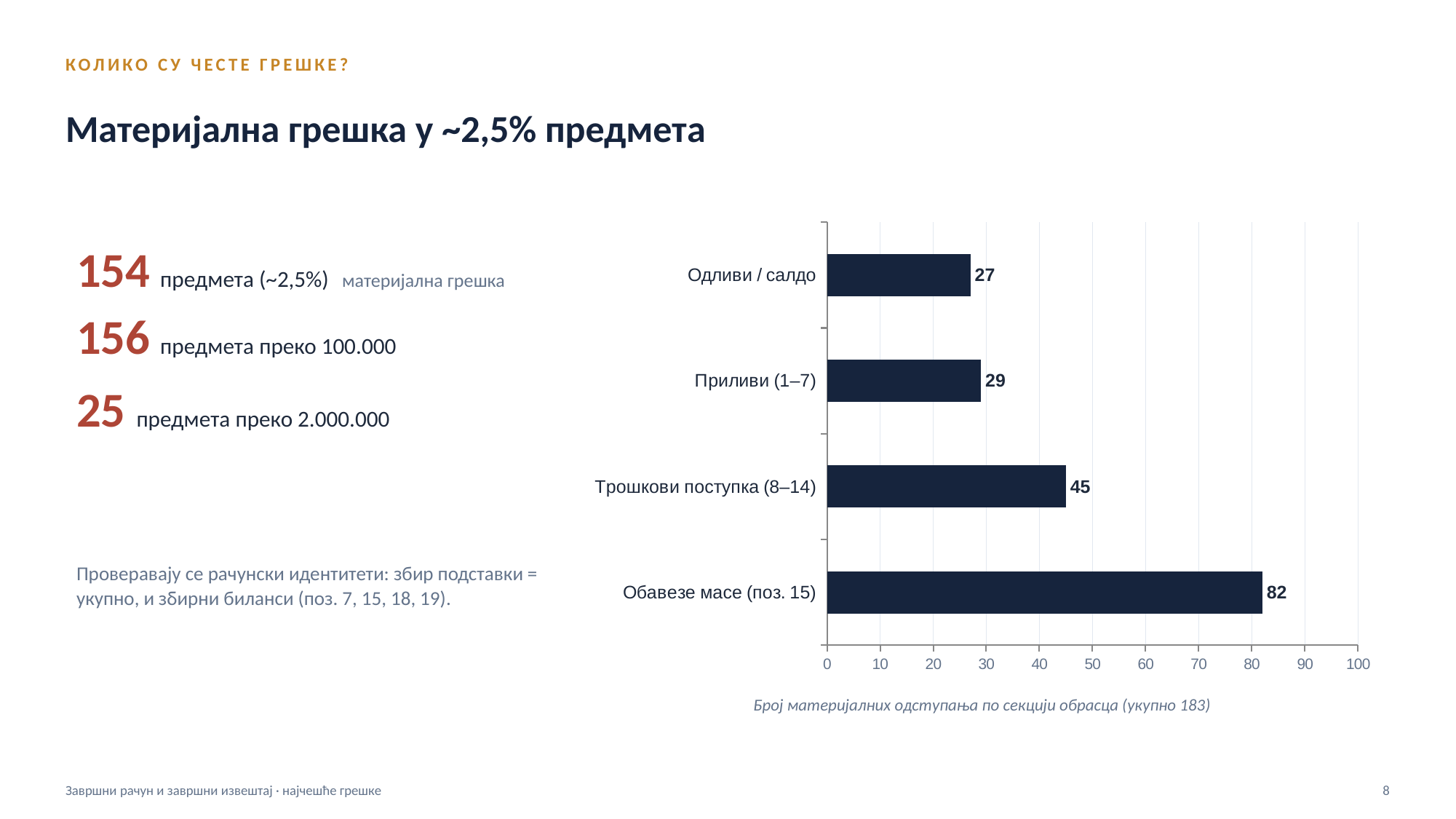
What is the value for Приливи (1–7)? 29 Which is larger, the value for Приливи (1–7) or the value for Одливи / салдо? Приливи (1–7) Which category has the lowest value? Одливи / салдо Which category has the highest value? Обавезе масе (поз. 15) Is the value for Трошкови поступка (8–14) greater or less than 40? greater How many categories are shown in the chart? 4 What is the value for Обавезе масе (поз. 15)? 82 What is the value for Трошкови поступка (8–14)? 45 What is the difference between the values for Обавезе масе (поз. 15) and Трошкови поступка (8–14)? 37 What is the caption below the chart? Број материјалних одступања по секцији обрасца (укупно 183) What is the value for Одливи / салдо? 27 What kind of chart is shown on the slide? bar chart